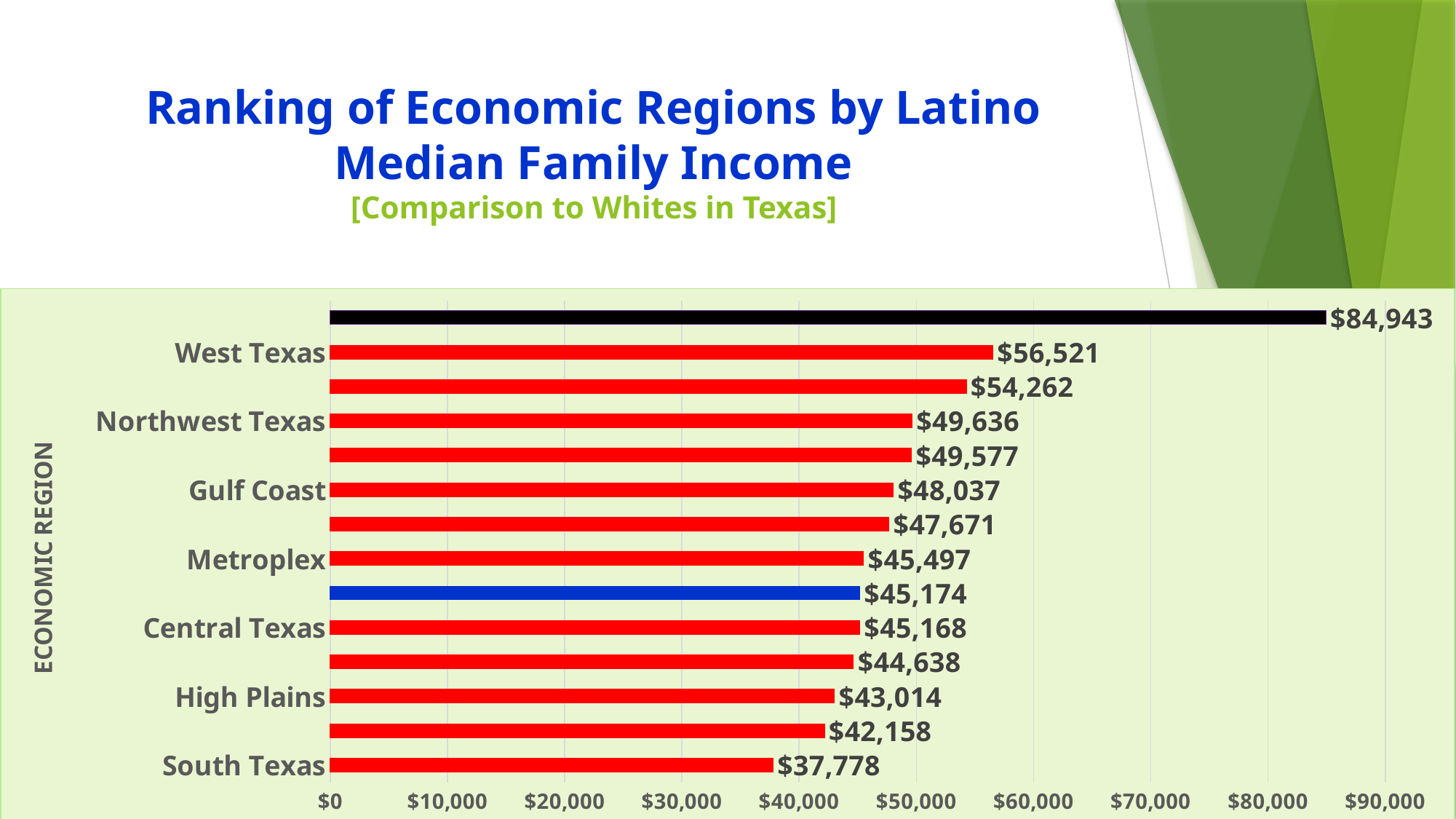
Which labeled economic region has the lowest value? South Texas What is the largest value printed on the chart? $84,943 What is the value shown for High Plains? $43,014 What is the Latino median family income for West Texas? $56,521 How many bars are plotted on the chart? 14 Which is larger, the value for Gulf Coast or the value for Central Texas? Gulf Coast What is the value shown for South Texas? $37,778 Which labeled economic region has the highest value among the red bars? West Texas What is the difference between the values for West Texas and South Texas? $18,743 What type of chart is shown on the slide? Bar chart What is the value shown for Gulf Coast? $48,037 What is the difference between the values for Northwest Texas and Metroplex? $4,139